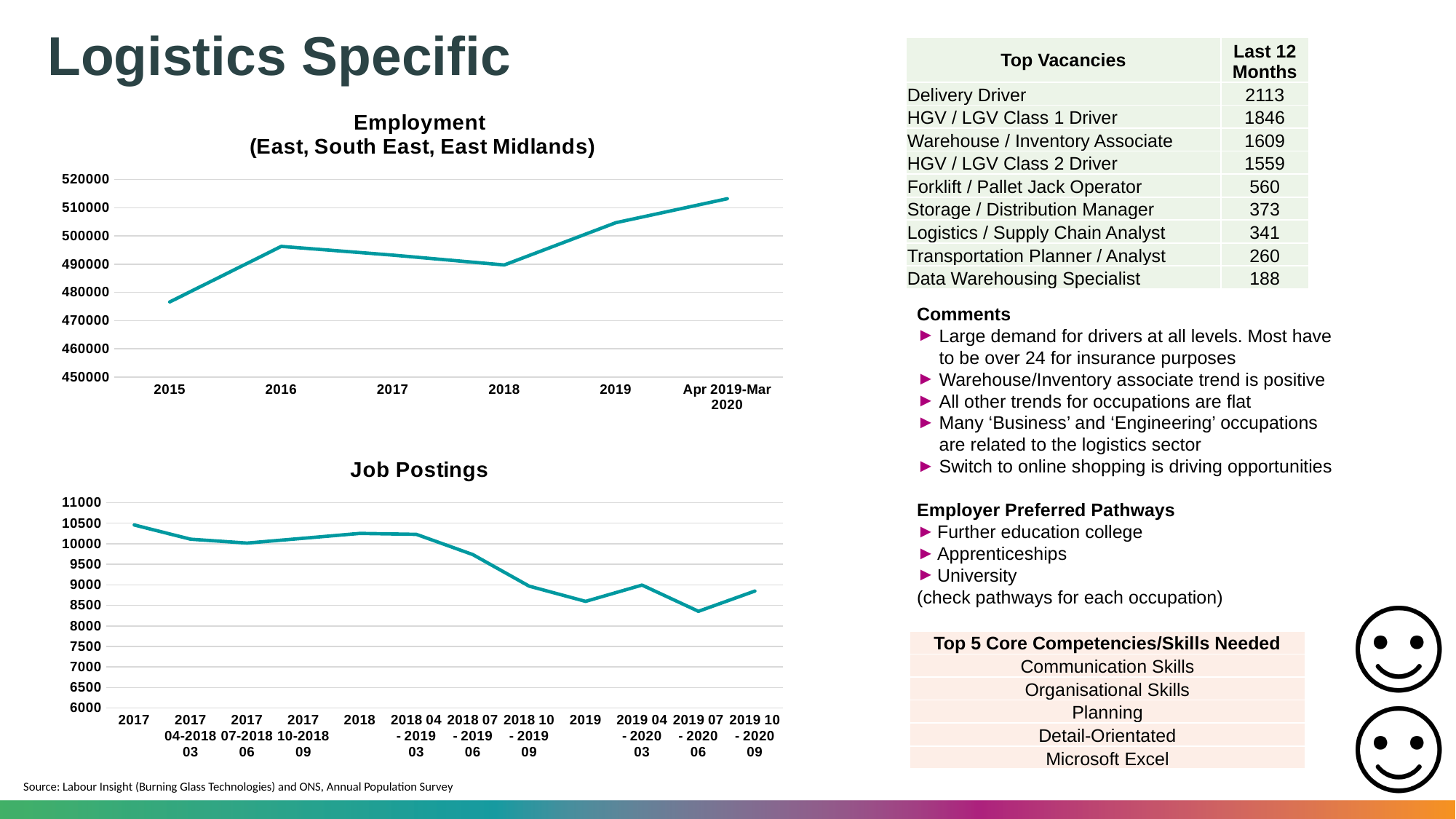
How many periods are plotted on the Job Postings chart? 12 How many data points are plotted on the Employment chart? 6 On the Employment chart, is the value for 2019 greater or less than 500000? greater On the Job Postings chart, which period has the highest number of job postings? 2017 On the Employment chart, is the value for 2015 greater or less than 480000? less On the Job Postings chart, which period has the lowest number of job postings? 2019 07 - 2020 06 On the Job Postings chart, do the values generally rise or fall from 2017 to 2019 10 - 2020 09? fall What type of chart is the Job Postings chart? Line chart On the Employment chart, which is larger, the value for 2016 or the value for 2018? 2016 On the Employment (East, South East, East Midlands) chart, which period has the highest employment value? Apr 2019-Mar 2020 On the Job Postings chart, is the value for 2019 greater or less than 9000? less On the Employment (East, South East, East Midlands) chart, which year has the lowest employment value? 2015